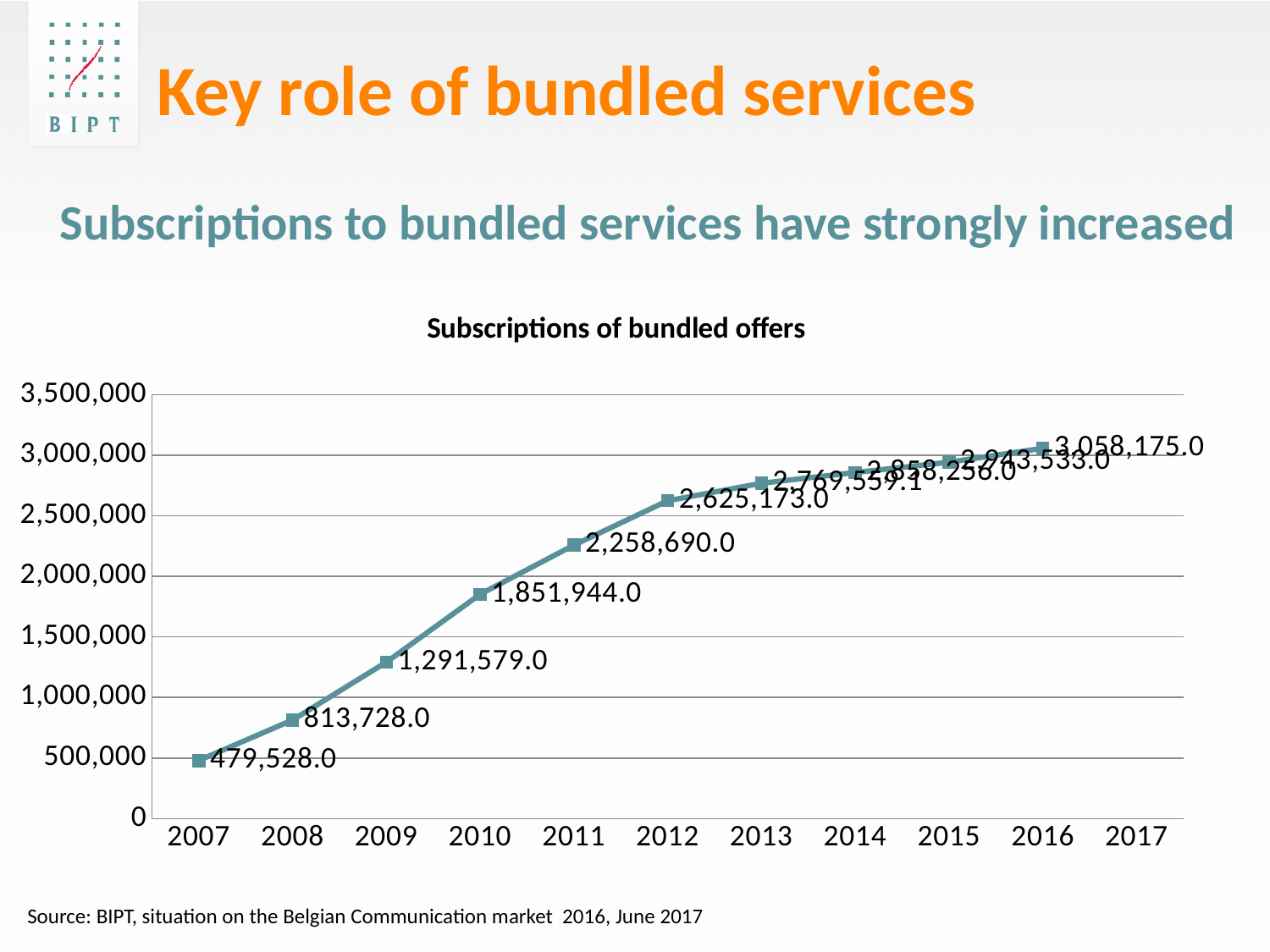
What type of chart is shown on the slide? line chart Is the value for 2013 greater or less than 2,500,000? greater What is the difference between the values for 2008 and 2007? 334,200.0 Which year has the highest value? 2016 What is the value for 2012? 2,625,173.0 What is the value for 2016? 3,058,175.0 Which year has the lowest value? 2007 Is the value for 2015 greater or less than 3,000,000? less What is the value for 2010? 1,851,944.0 Do the values rise or fall from 2007 to 2016? rise What is the value for 2007? 479,528.0 What is the title of the chart? Subscriptions of bundled offers